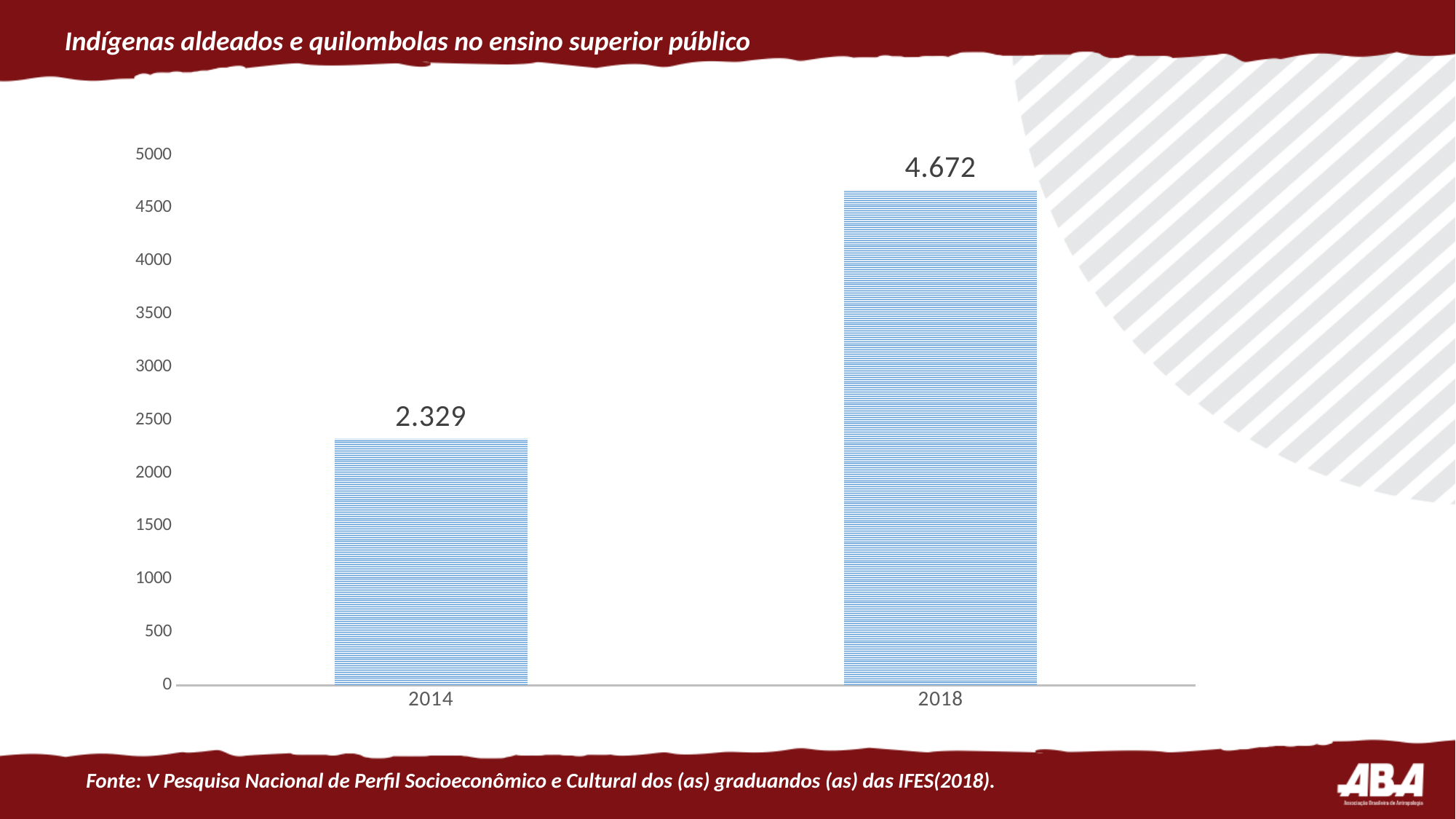
What is the value for 2018? 4.672 Which is larger, the value for 2014 or the value for 2018? 2018 Is the value for 2018 greater or less than 4500? greater What is the difference between the values for 2018 and 2014? 2.343 Do the values rise or fall from 2014 to 2018? rise How many years are shown on the x axis? 2 Which year has the highest value? 2018 Which year has the lowest value? 2014 What is the title of the slide? Indígenas aldeados e quilombolas no ensino superior público What is the value for 2014? 2.329 What kind of chart is shown on the slide? bar chart Is the value for 2014 greater or less than 2500? less